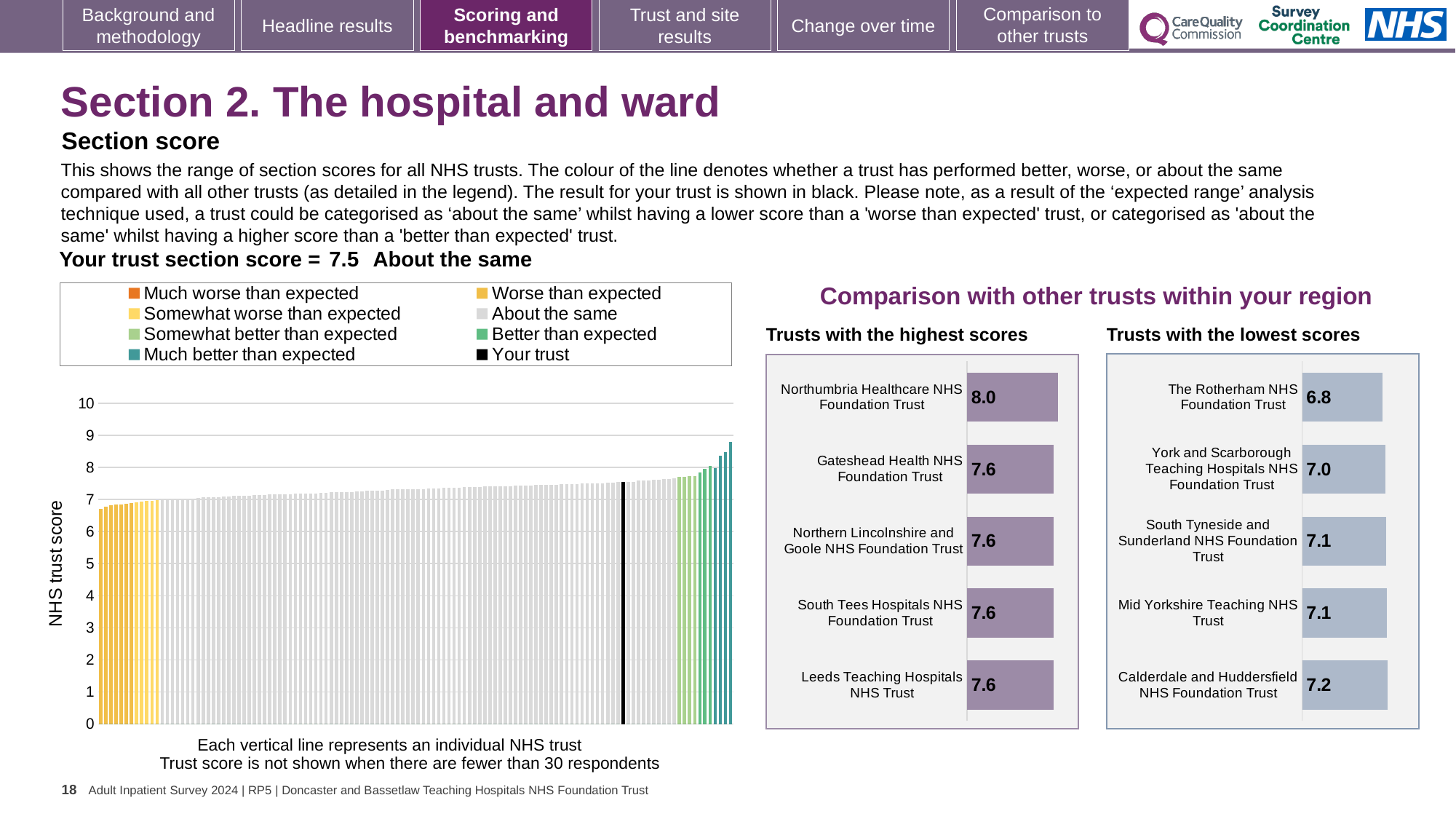
How many trusts are shown in the 'Trusts with the highest scores' chart? 5 In the large chart on the left, is the value of the black bar representing your trust greater or less than 5? greater In the large chart on the left, how many entries does the legend list? 8 In the 'Trusts with the highest scores' chart, what is the difference between the scores of Northumbria Healthcare NHS Foundation Trust and Gateshead Health NHS Foundation Trust? 0.4 What kind of chart is the large chart on the left showing NHS trust scores? Bar chart In the 'Trusts with the highest scores' chart, which trust has the highest score? Northumbria Healthcare NHS Foundation Trust How many trusts are shown in the 'Trusts with the lowest scores' chart? 5 In the 'Trusts with the lowest scores' chart, which trust has the lowest score? The Rotherham NHS Foundation Trust In the 'Trusts with the lowest scores' chart, how much higher is Calderdale and Huddersfield NHS Foundation Trust's score than The Rotherham NHS Foundation Trust's score? 0.4 In the 'Trusts with the lowest scores' chart, what is the score for The Rotherham NHS Foundation Trust? 6.8 In the 'Trusts with the highest scores' chart, what is the score for Northumbria Healthcare NHS Foundation Trust? 8.0 In the 'Trusts with the lowest scores' chart, which has the larger score: York and Scarborough Teaching Hospitals NHS Foundation Trust or Calderdale and Huddersfield NHS Foundation Trust? Calderdale and Huddersfield NHS Foundation Trust